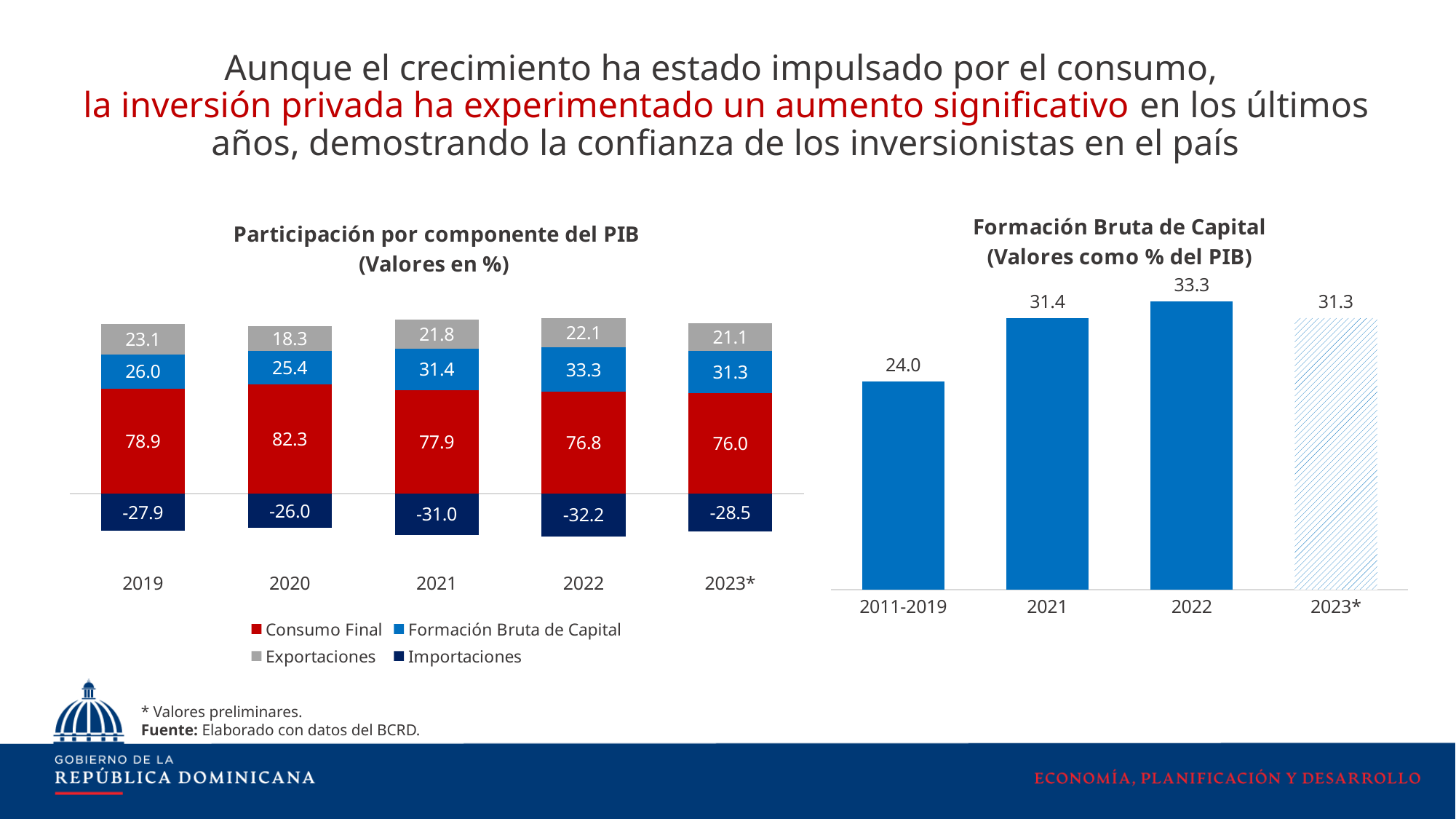
In the 'Participación por componente del PIB' chart, what is the value of Consumo Final for 2020? 82.3 In the 'Participación por componente del PIB' chart, what is the difference between Consumo Final in 2019 and 2023*? 2.9 In the 'Participación por componente del PIB' chart, what is the value of Importaciones for 2022? -32.2 In the 'Formación Bruta de Capital' chart, how many bars are shown? 4 In the 'Participación por componente del PIB' chart, which year has the highest Consumo Final value? 2020 In the 'Formación Bruta de Capital' chart, which period has the highest value? 2022 In the 'Participación por componente del PIB' chart, which year has the lowest Exportaciones value? 2020 What kind of chart is the 'Formación Bruta de Capital' chart? Bar chart In the 'Formación Bruta de Capital' chart, what is the value for 2011-2019? 24.0 In the 'Participación por componente del PIB' chart, what is the value of Exportaciones for 2019? 23.1 In the 'Participación por componente del PIB' chart, how many series does the legend list? 4 In the 'Formación Bruta de Capital' chart, what is the difference between the 2022 and 2011-2019 values? 9.3